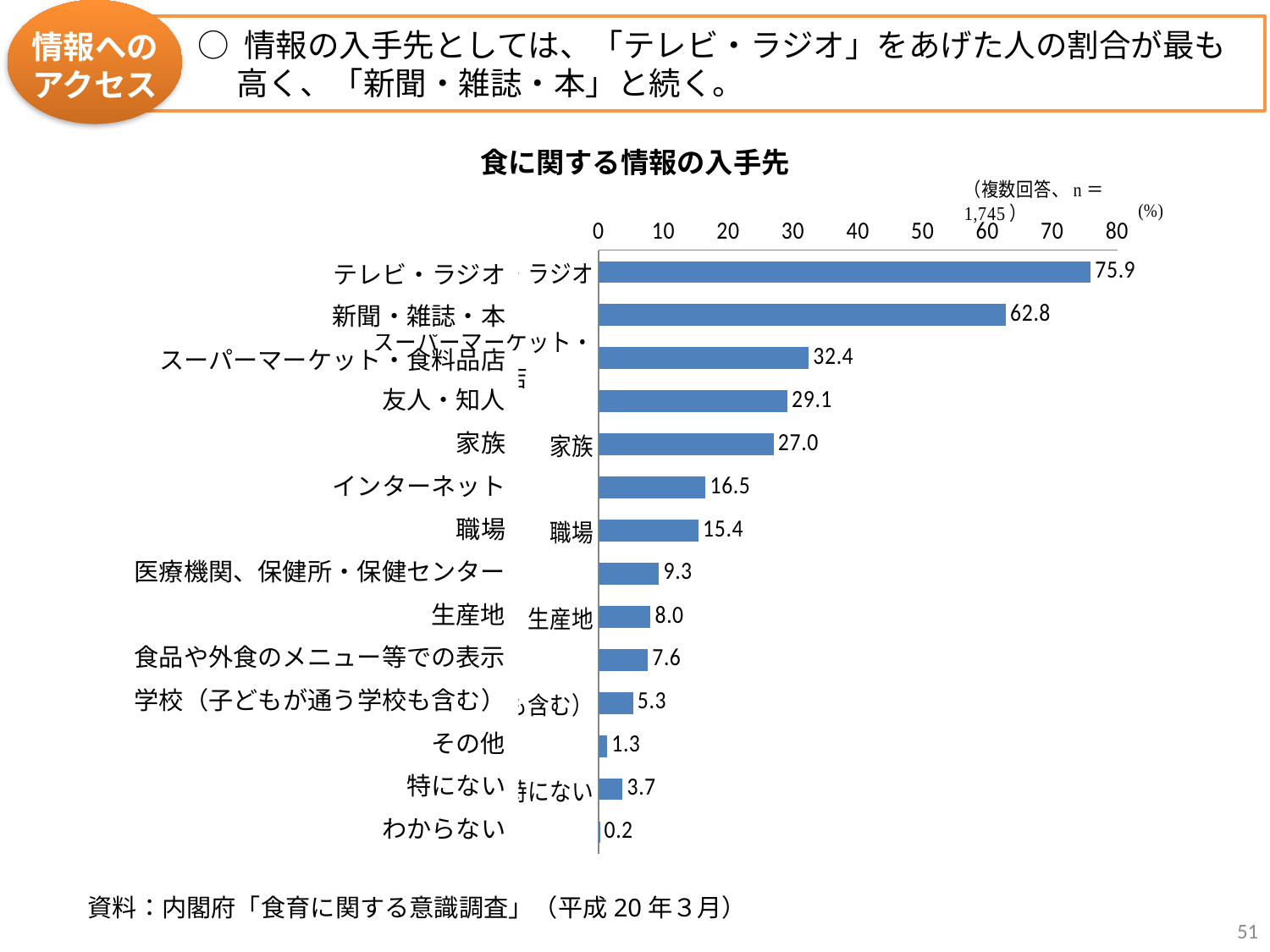
Is the value for スーパーマーケット・食料品店 greater or less than 30? greater What kind of chart is shown on the slide? bar chart What is the value for 医療機関、保健所・保健センター? 9.3 Which is larger, the value for 友人・知人 or the value for 家族? 友人・知人 What is the value for インターネット? 16.5 Which category has the lowest value? わからない What is the difference between the values for テレビ・ラジオ and 新聞・雑誌・本? 13.1 Which category has the highest value? テレビ・ラジオ What is the value for テレビ・ラジオ? 75.9 How many categories are shown in the chart? 14 What is the value for 新聞・雑誌・本? 62.8 What is the title of the chart? 食に関する情報の入手先